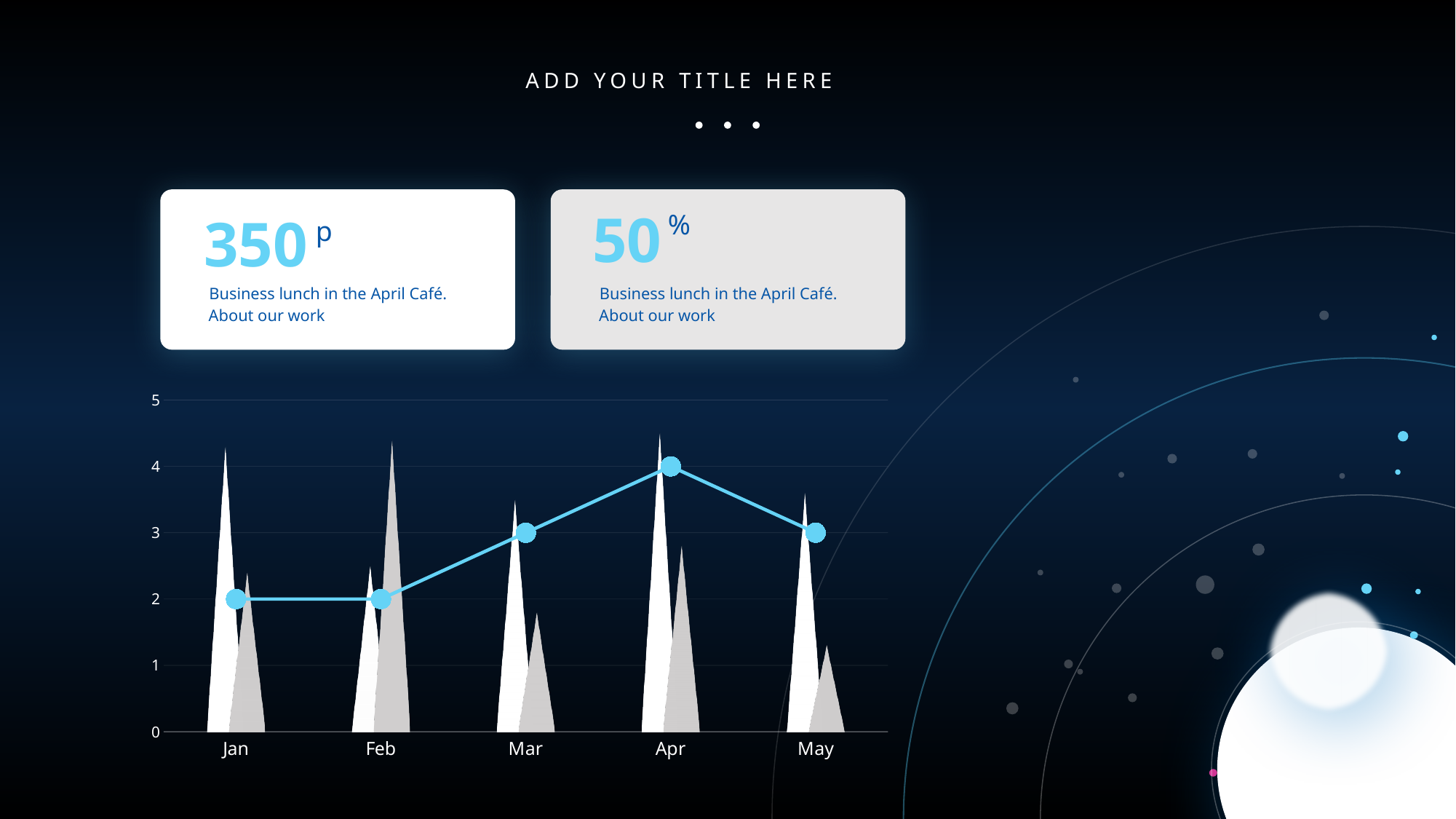
What is the value of the line at Mar? 3 What is the value of the line at Apr? 4 Is the value for Apr greater or less than 3? greater What is the value of the line at May? 3 How many categories are shown on the x axis of the chart? 5 Which month has the highest value on the line? Apr Does the line rise or fall from Feb to Apr? rise What is the value of the line at Jan? 2 What is the highest value shown on the y axis of the chart? 5 What type of chart is shown on the slide? combination bar and line chart